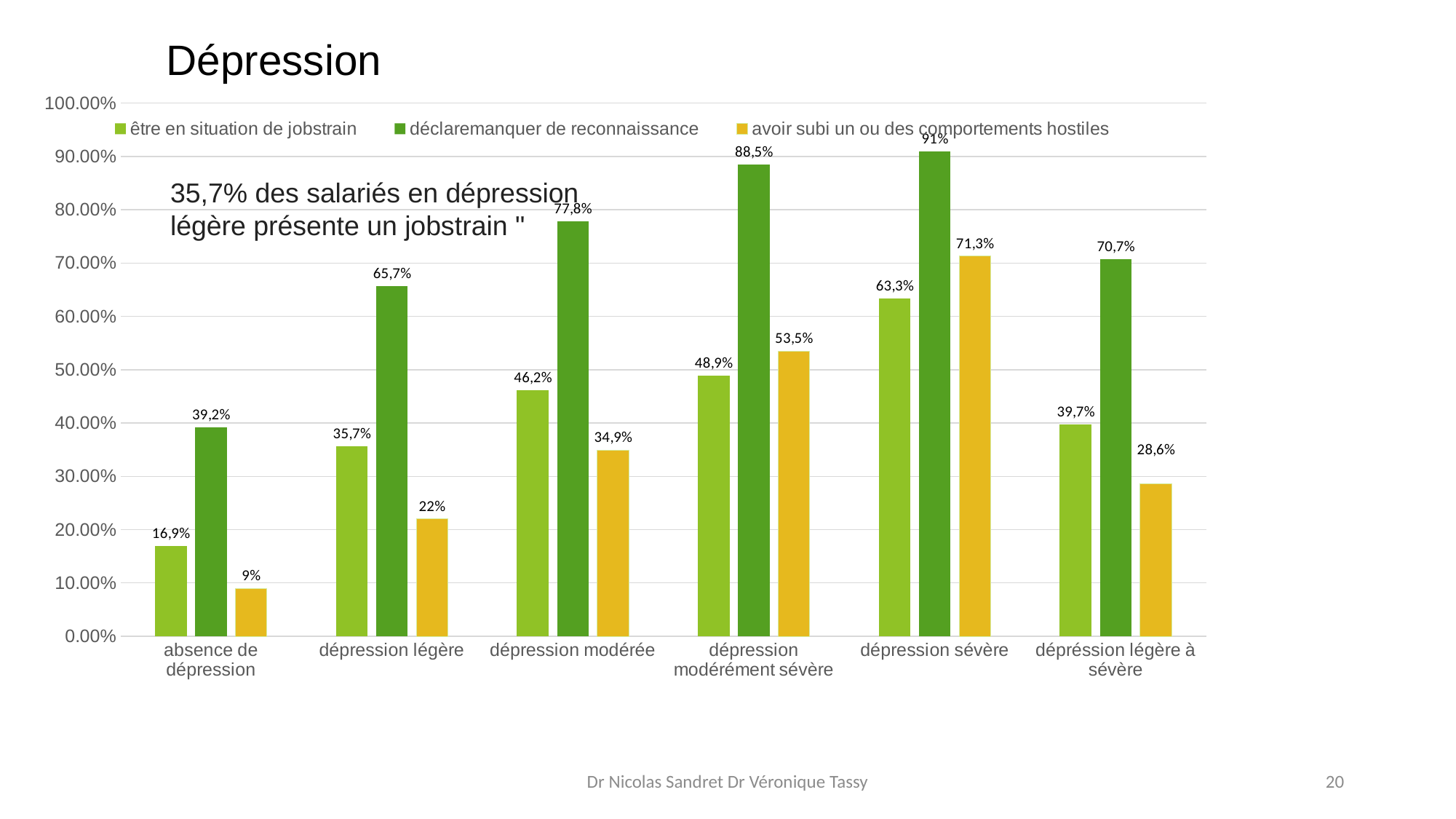
Which category has the highest value for 'avoir subi un ou des comportements hostiles'? dépression sévère What is the value for 'déclaremanquer de reconnaissance' in the 'dépression sévère' category? 91% How many series does the legend list? 3 In the 'dépression modérément sévère' category, which is larger: 'être en situation de jobstrain' or 'avoir subi un ou des comportements hostiles'? avoir subi un ou des comportements hostiles What is the difference between 'déclaremanquer de reconnaissance' and 'être en situation de jobstrain' in the 'dépression modérée' category? 31,6% Which category has the lowest value for 'être en situation de jobstrain'? absence de dépression What kind of chart is shown on the slide? bar chart How many categories are shown on the x axis? 6 What is the title of the chart? Dépression Is the value for 'déclaremanquer de reconnaissance' in 'dépréssion légère à sévère' greater or less than 60.00%? greater What is the value for 'avoir subi un ou des comportements hostiles' in the 'absence de dépression' category? 9% What is the value for 'être en situation de jobstrain' in the 'dépression légère' category? 35,7%